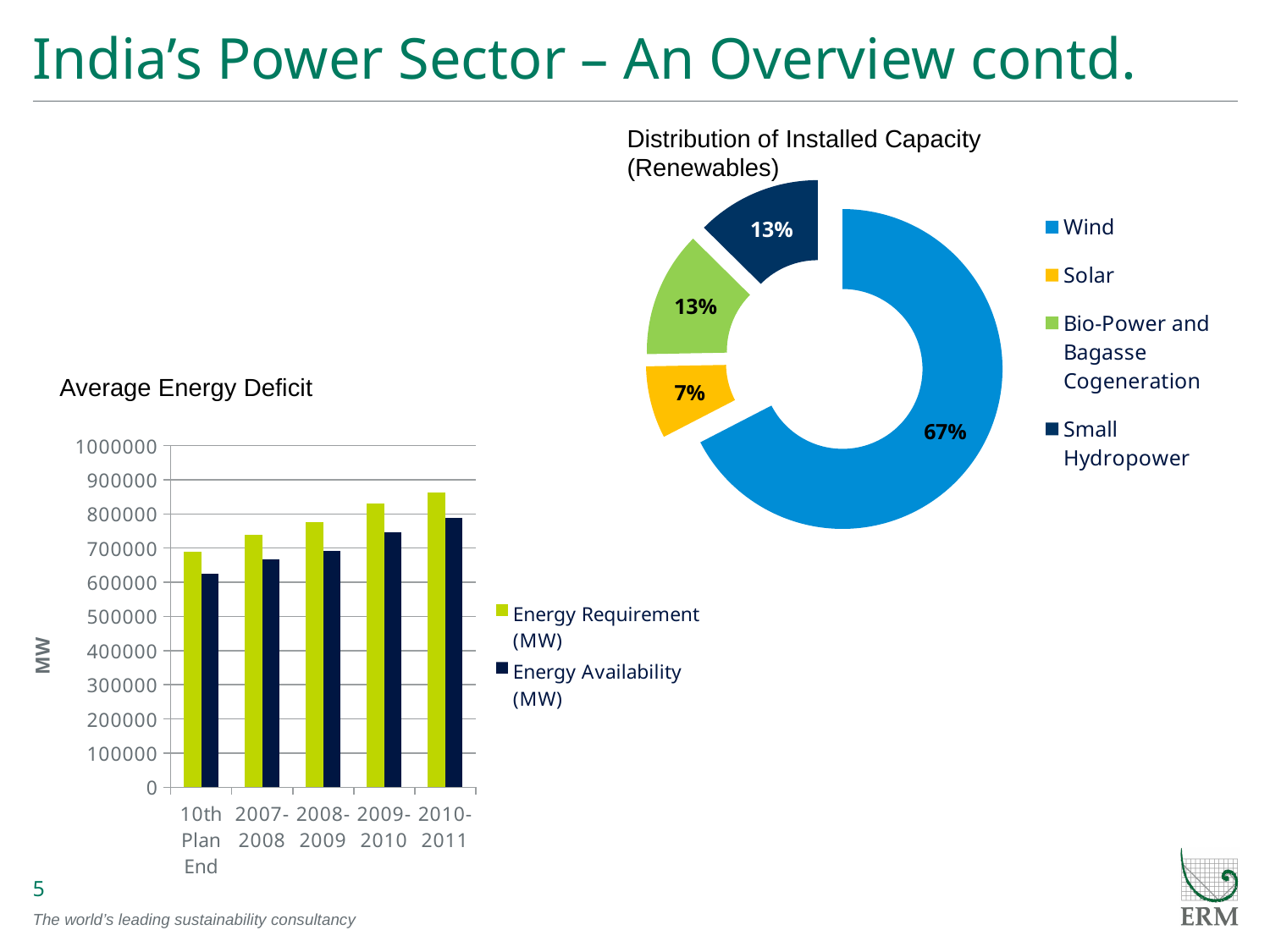
What kind of chart is the Distribution of Installed Capacity (Renewables) chart? Doughnut (pie) chart How many series does the legend of the Average Energy Deficit chart list? 2 How many categories are shown in the Distribution of Installed Capacity (Renewables) chart? 4 In the Distribution of Installed Capacity (Renewables) chart, what share does Wind have? 67% In the Distribution of Installed Capacity (Renewables) chart, what is the difference between the Wind share and the Solar share? 60% In the Distribution of Installed Capacity (Renewables) chart, what share does Solar have? 7% In the Average Energy Deficit chart, which is larger for 2010-2011: Energy Requirement (MW) or Energy Availability (MW)? Energy Requirement (MW) In the Average Energy Deficit chart, is the Energy Requirement (MW) value for 2010-2011 greater or less than 800000? greater In the Distribution of Installed Capacity (Renewables) chart, which category has the smallest share? Solar What kind of chart is the Average Energy Deficit chart? Bar chart In the Distribution of Installed Capacity (Renewables) chart, which category has the largest share? Wind In the Average Energy Deficit chart, does Energy Requirement (MW) rise or fall from 10th Plan End to 2010-2011? Rise